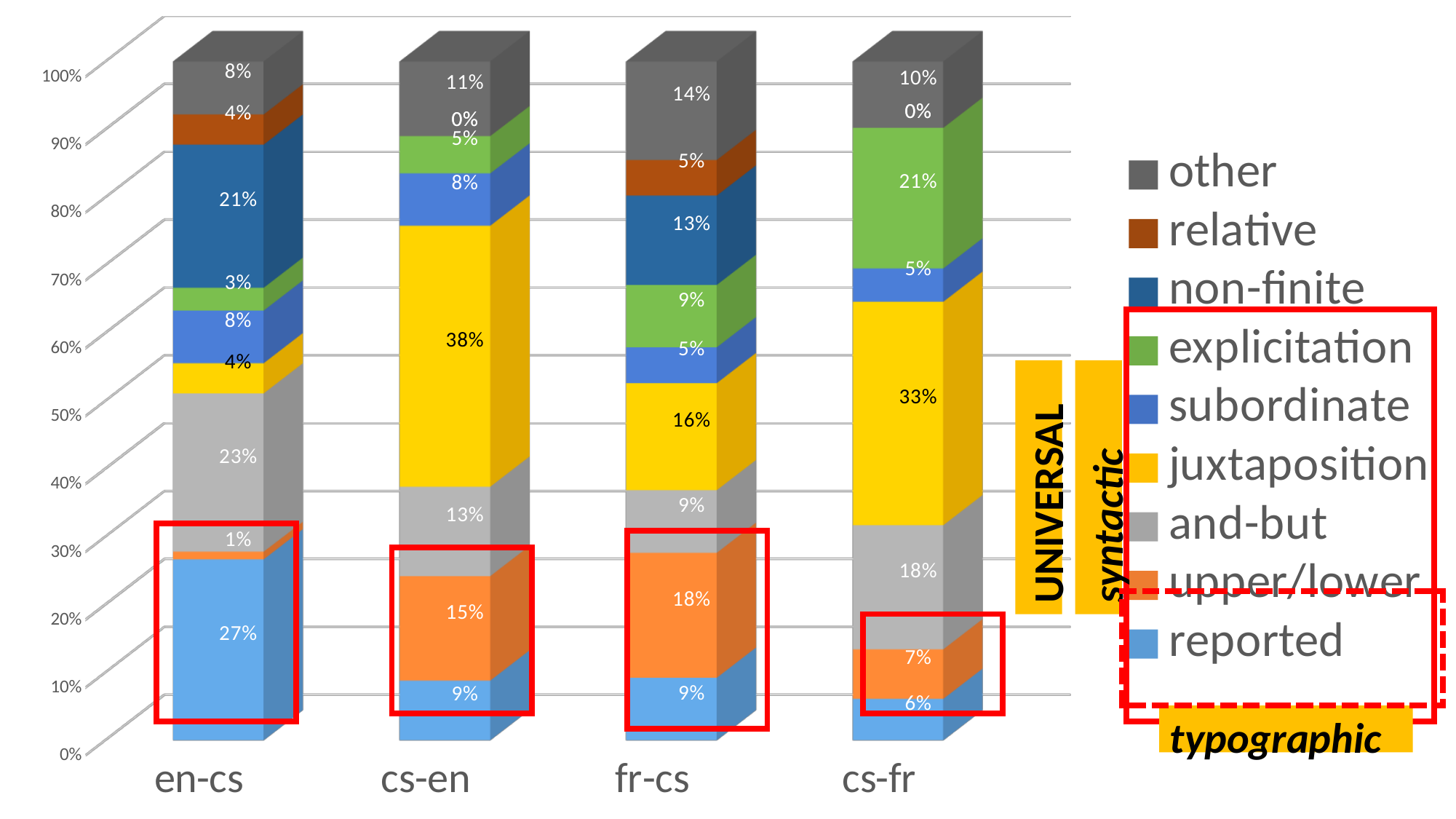
Which has a larger and-but share, en-cs or cs-fr? en-cs Which language pair has the highest juxtaposition share? cs-en How many series does the legend list? 9 What is the value of the non-finite segment for fr-cs? 13% What is the value of the juxtaposition segment for cs-en? 38% What is the difference between the upper/lower values for fr-cs and cs-en? 3% What kind of chart is this? Stacked bar chart What is the value of the reported segment for en-cs? 27% Which language pair has the lowest reported share? cs-fr What is the value of the explicitation segment for cs-fr? 21% Which language pair has the highest reported share? en-cs How many language pairs are shown on the x axis? 4